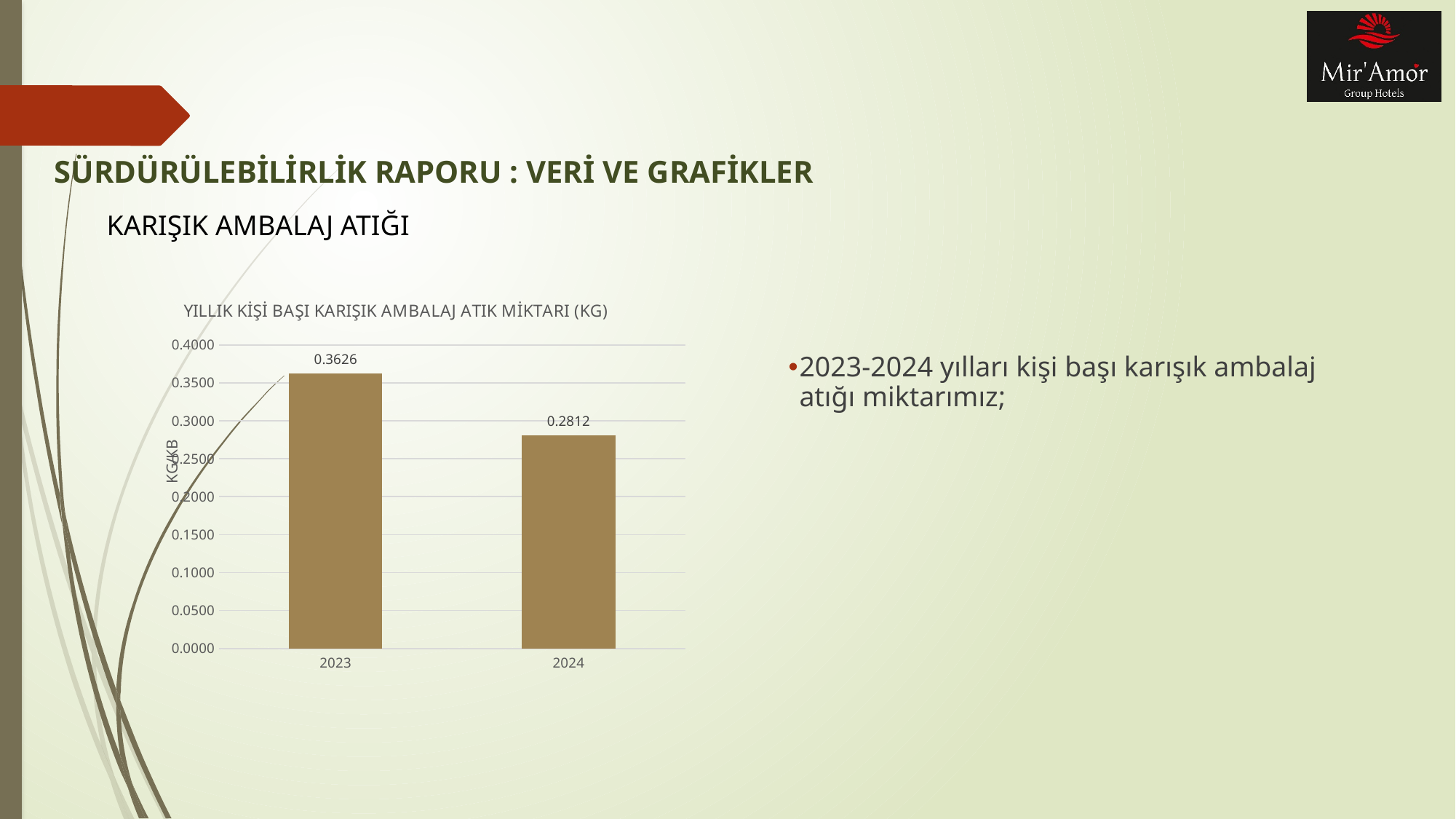
Which is larger, the value for 2023 or the value for 2024? 2023 What is the difference between the 2023 and 2024 values? 0.0814 Is the value for 2024 greater or less than 0.3000? less Which year has the highest value? 2023 How many years are shown on the x axis? 2 What is the title of the chart? YILLIK KİŞİ BAŞI KARIŞIK AMBALAJ ATIK MİKTARI (KG) Is the value for 2023 greater or less than 0.3500? greater What is the value for 2023? 0.3626 What is the value for 2024? 0.2812 What kind of chart is shown? bar chart Do the values rise or fall from 2023 to 2024? fall Which year has the lowest value? 2024